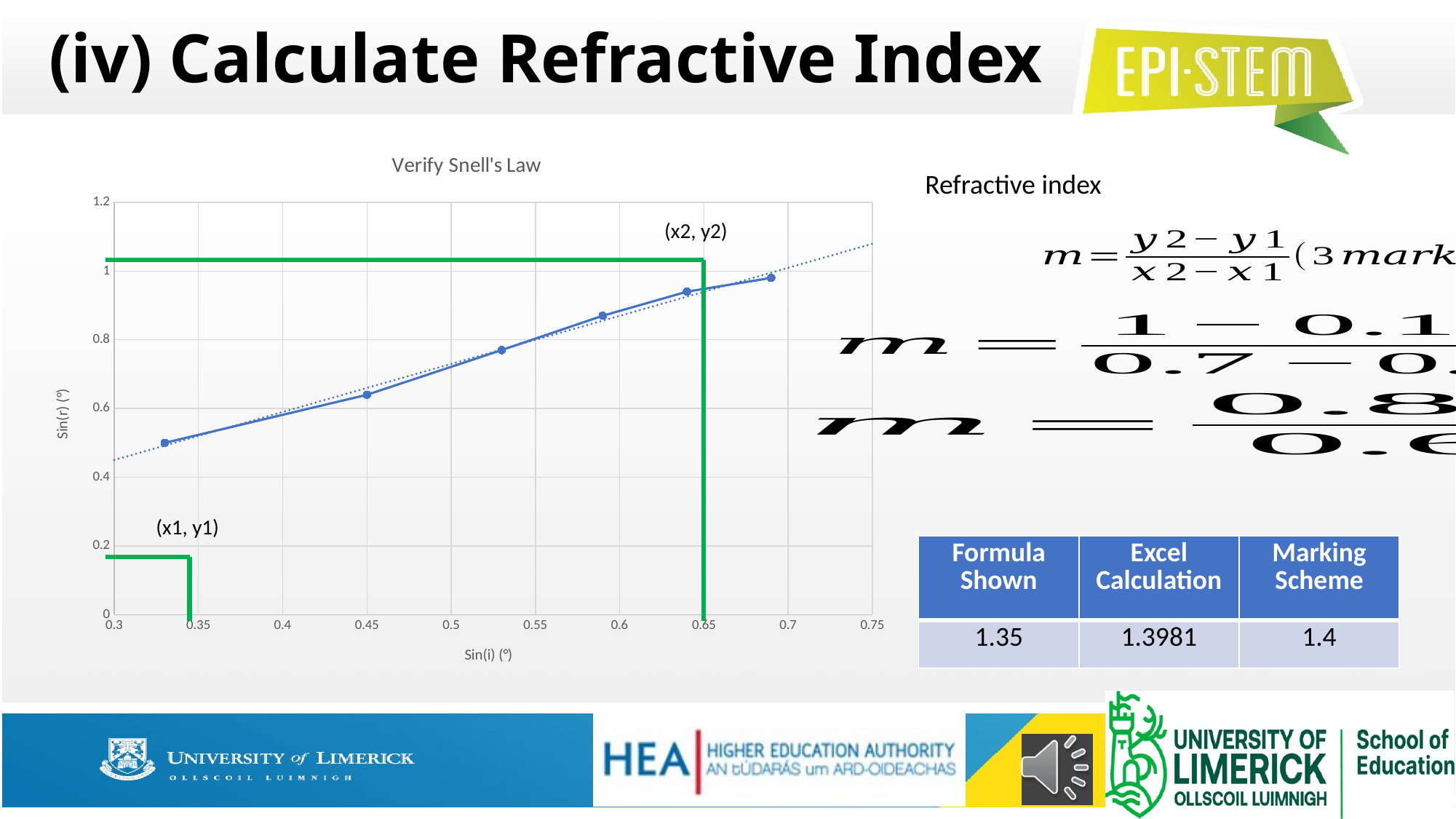
Do the Sin(r) values rise or fall as Sin(i) increases along the x axis? rise Which data point has the lowest Sin(r) value, the leftmost or the rightmost? leftmost Is the Sin(r) value of the rightmost data point greater or less than 0.8? greater Which has the larger Sin(r) value, the third data point from the left or the fourth data point from the left? the fourth How many data points are plotted on the chart? 6 What is the label on the x axis of the chart? Sin(i) (°) What kind of chart is shown on the slide? line chart Is the Sin(r) value of the second data point from the left greater or less than 0.8? less Which data point has the highest Sin(r) value, the leftmost or the rightmost? rightmost Is the Sin(r) value of the leftmost data point greater or less than 0.6? less What is the title of the chart? Verify Snell's Law